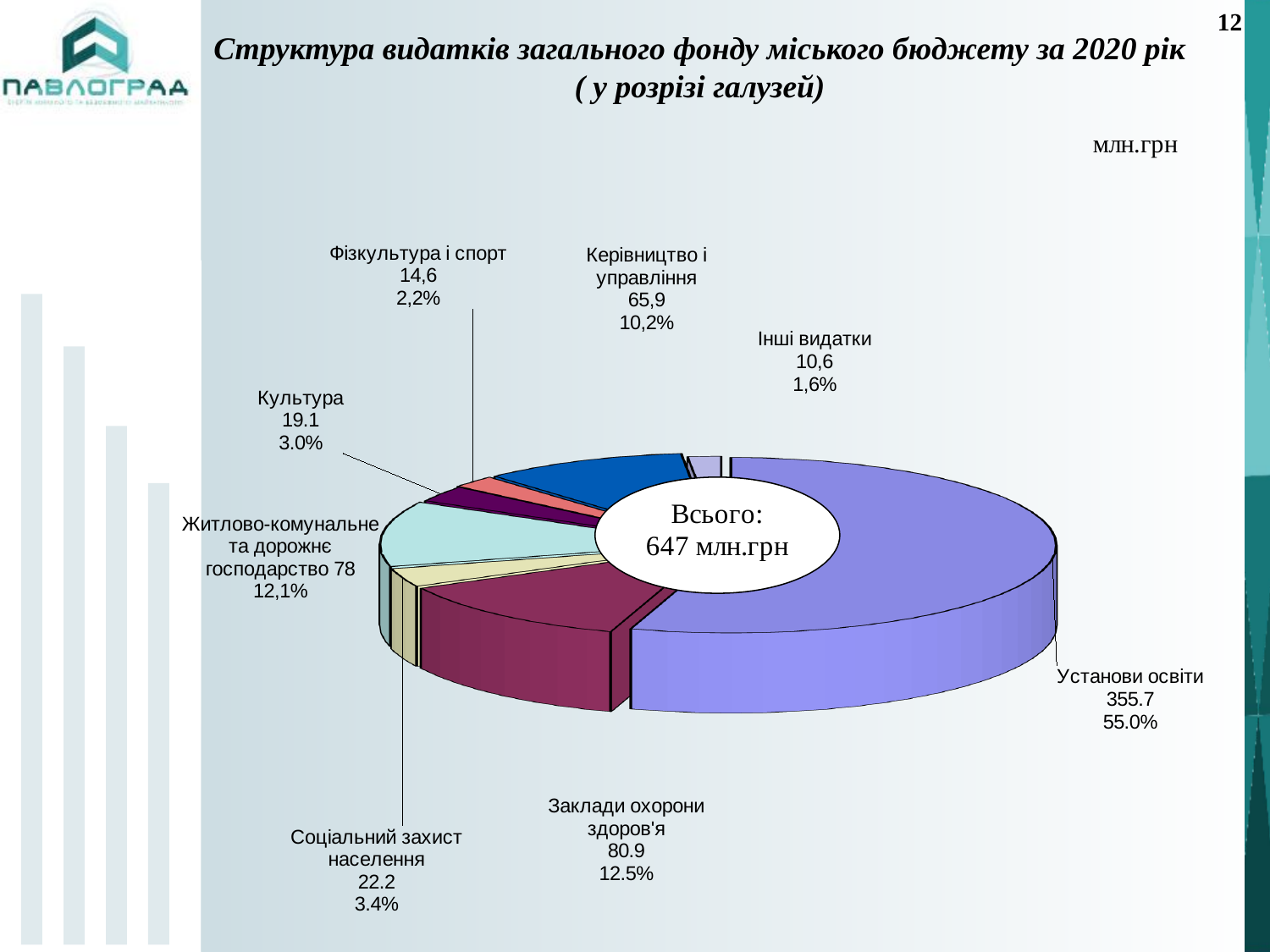
What share of the pie does Житлово-комунальне та дорожнє господарство represent? 12,1% What is the value for Установи освіти? 355.7 What type of chart is shown on the slide? pie chart Which category has the largest share of the pie? Установи освіти What is the value for Заклади охорони здоров'я? 80.9 How many categories are shown in the pie chart? 8 What share of the pie does Установи освіти represent? 55.0% Which is larger, the value for Культура or the value for Соціальний захист населення? Соціальний захист населення What is the value for Керівництво і управління? 65,9 Which category has the smallest share of the pie? Інші видатки What total is shown in the centre of the pie chart? 647 млн.грн What is the difference between the values for Заклади охорони здоров'я and Житлово-комунальне та дорожнє господарство? 2.9